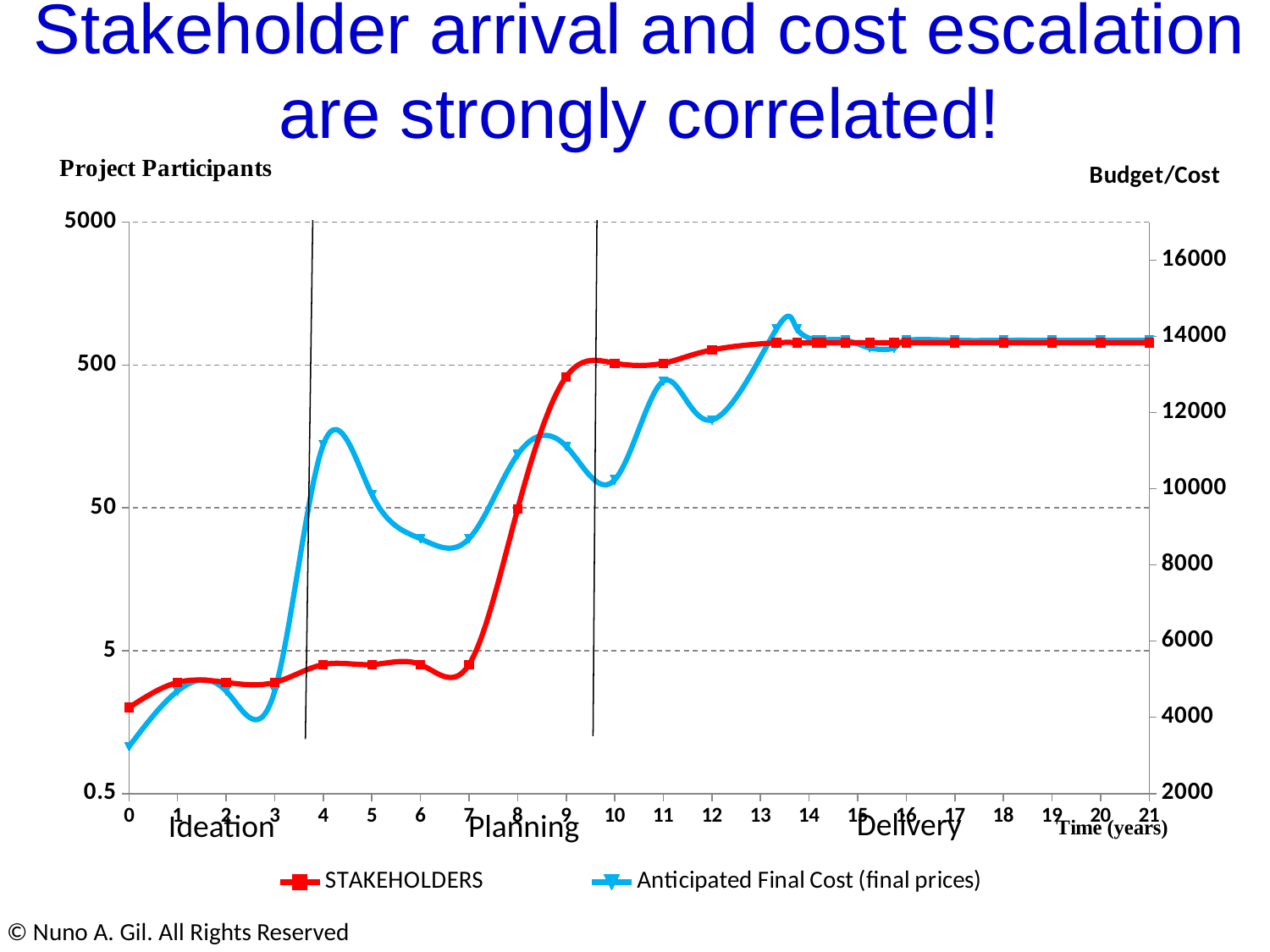
Which is larger, the Anticipated Final Cost at year 4 or at year 6? Year 4 What are the two series named in the legend? STAKEHOLDERS and Anticipated Final Cost (final prices) Is the STAKEHOLDERS value at year 0 greater or less than 5? less Is the STAKEHOLDERS value at year 14 greater or less than 500? greater What kind of chart is shown on the slide? Line chart What are the three project phases labelled along the x axis? Ideation, Planning, Delivery Does the STAKEHOLDERS series overall rise or fall from year 0 to year 21? rise How many series does the legend list? 2 How many time points (years) are marked on the x axis? 22 Is the Anticipated Final Cost at year 4 greater or less than 10000? greater At which year is the Anticipated Final Cost lowest? 0